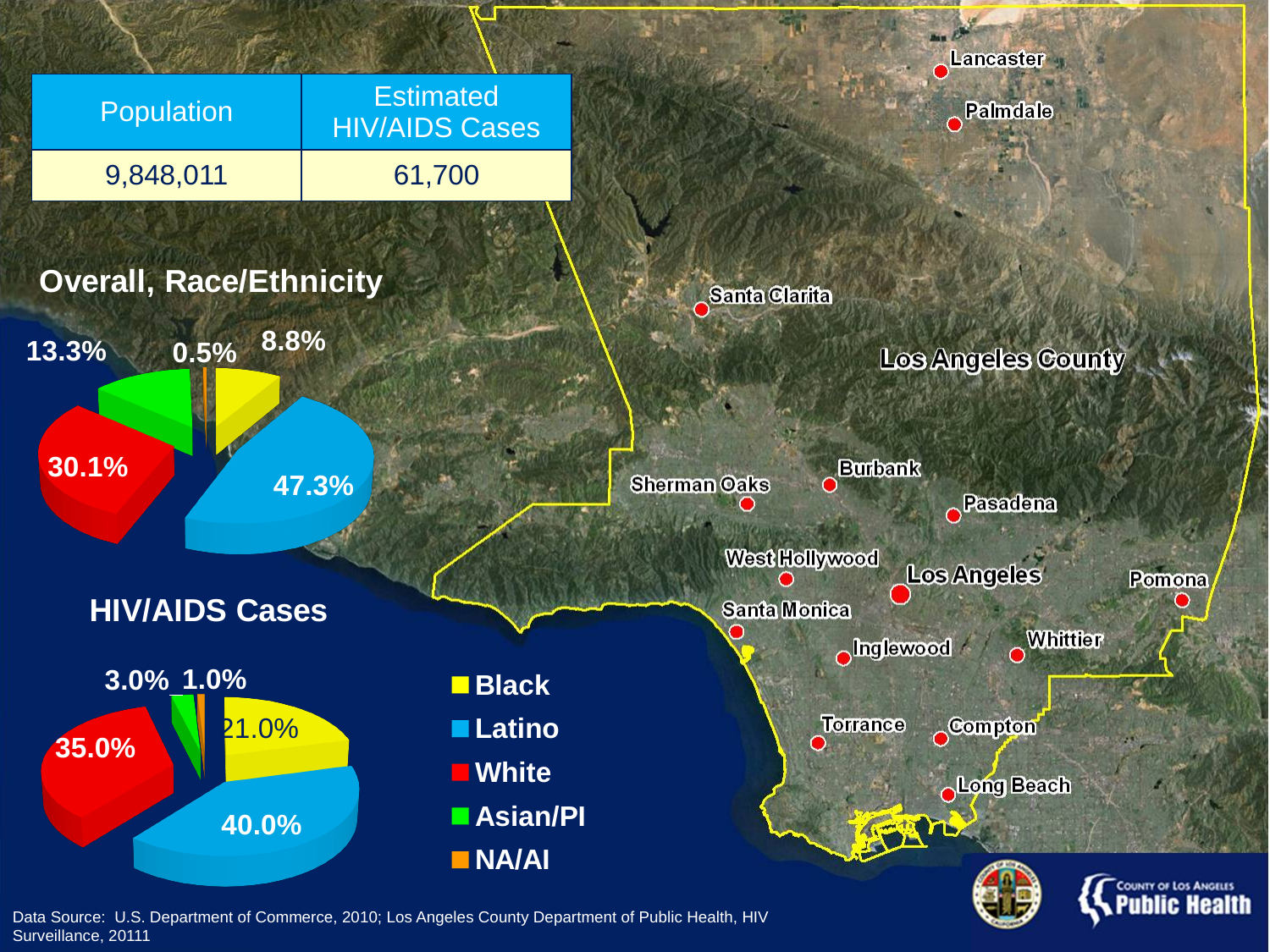
In the 'Overall, Race/Ethnicity' pie chart, what is the difference between the White share and the Black share? 21.3% What kind of chart is used for 'HIV/AIDS Cases'? Pie chart In the 'Overall, Race/Ethnicity' pie chart, what share is shown for NA/AI? 0.5% In the 'Overall, Race/Ethnicity' pie chart, which group has the largest share? Latino In the 'HIV/AIDS Cases' pie chart, what is the difference between the Latino share and the White share? 5.0% How many groups does the legend list for the pie charts? 5 In the 'HIV/AIDS Cases' pie chart, which group has the smallest share? NA/AI In the 'Overall, Race/Ethnicity' pie chart, what share is shown for Latino? 47.3% In the 'HIV/AIDS Cases' pie chart, what share is shown for Black? 21.0% In the 'Overall, Race/Ethnicity' pie chart, which is larger, the Asian/PI share or the Black share? Asian/PI In the 'HIV/AIDS Cases' pie chart, what share is shown for White? 35.0% Which colour represents Asian/PI in the pie charts? Green